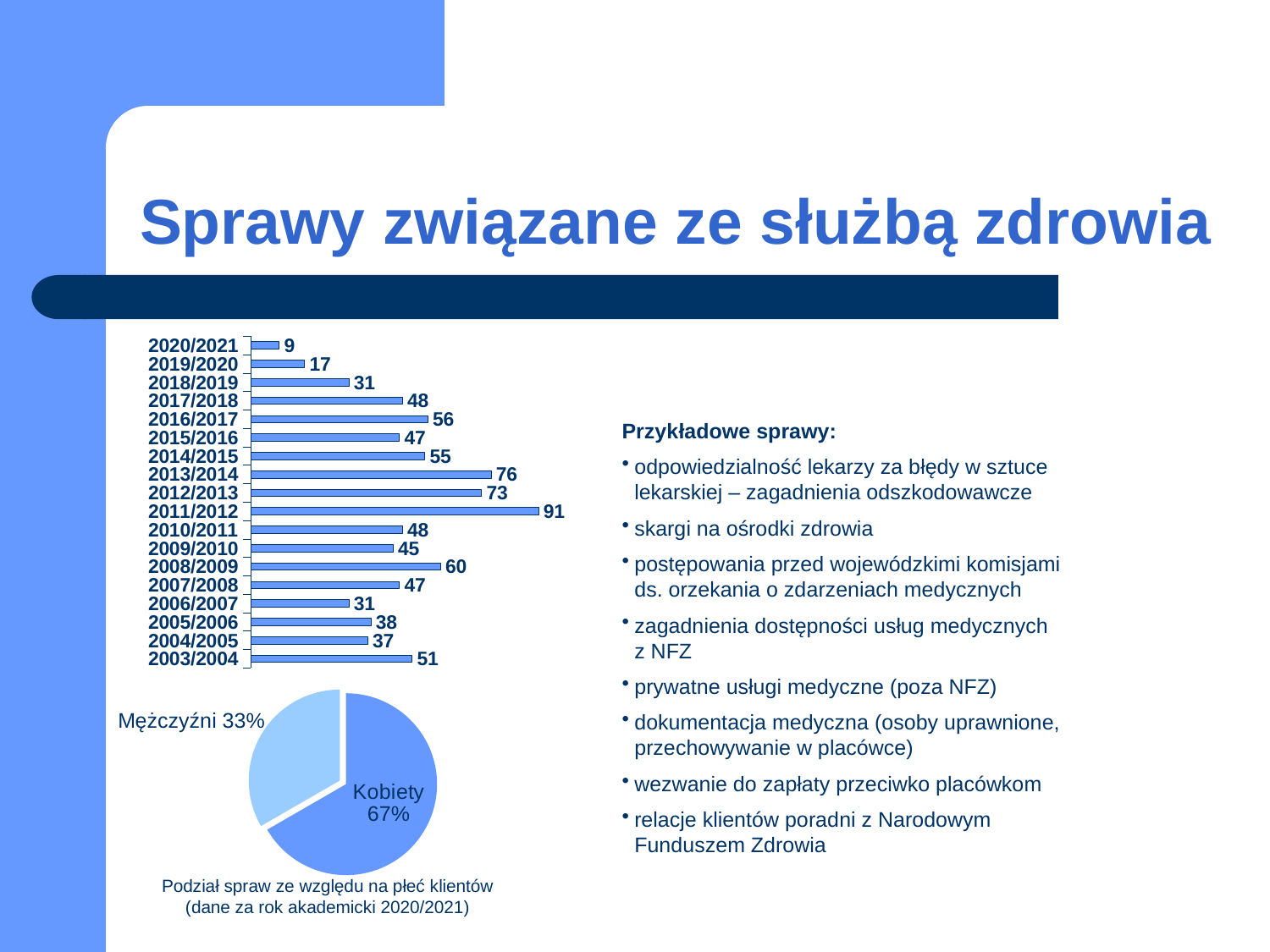
What kind of chart is the upper chart on the slide? bar chart In the bar chart, what is the difference between the values for 2013/2014 and 2012/2013? 3 In the pie chart, what share is labelled Kobiety? 67% In the bar chart, which academic year has the highest value? 2011/2012 In the pie chart, what share is labelled Mężczyźni? 33% In the bar chart, which is larger, the value for 2008/2009 or the value for 2014/2015? 2008/2009 In the bar chart, what is the value for 2011/2012? 91 What kind of chart is the lower chart on the slide? pie chart How many academic years are shown in the bar chart? 18 In the bar chart, which academic year has the lowest value? 2020/2021 In the bar chart, what is the value for 2020/2021? 9 In the bar chart, how do the values change from 2017/2018 to 2020/2021? they fall